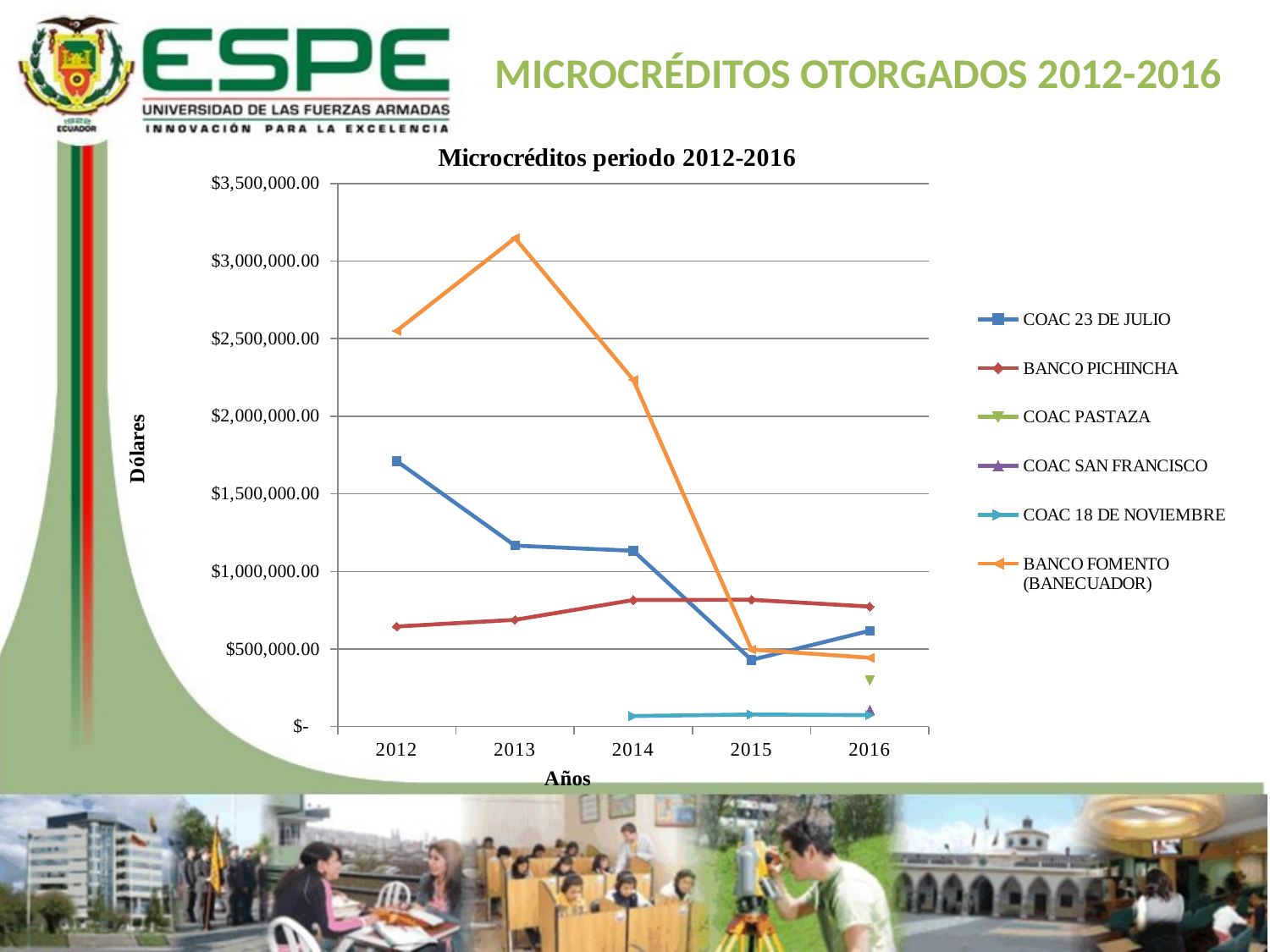
How many years are shown on the x axis? 5 Does the value for COAC 23 DE JULIO rise or fall from 2012 to 2015? fall What is the title of the vertical axis? Dólares What kind of chart is shown on the slide? line chart Is the value for BANCO FOMENTO (BANECUADOR) in 2015 greater or less than $1,000,000.00? less In which year does COAC 23 DE JULIO have its lowest value? 2015 In 2012, which is larger: COAC 23 DE JULIO or BANCO PICHINCHA? COAC 23 DE JULIO How many series does the legend list? 6 Is the value for COAC 23 DE JULIO in 2012 greater or less than $1,500,000.00? greater Is the value for BANCO FOMENTO (BANECUADOR) in 2013 greater or less than $3,000,000.00? greater Which series has the highest value in 2013? BANCO FOMENTO (BANECUADOR) In which year does BANCO FOMENTO (BANECUADOR) reach its highest value? 2013